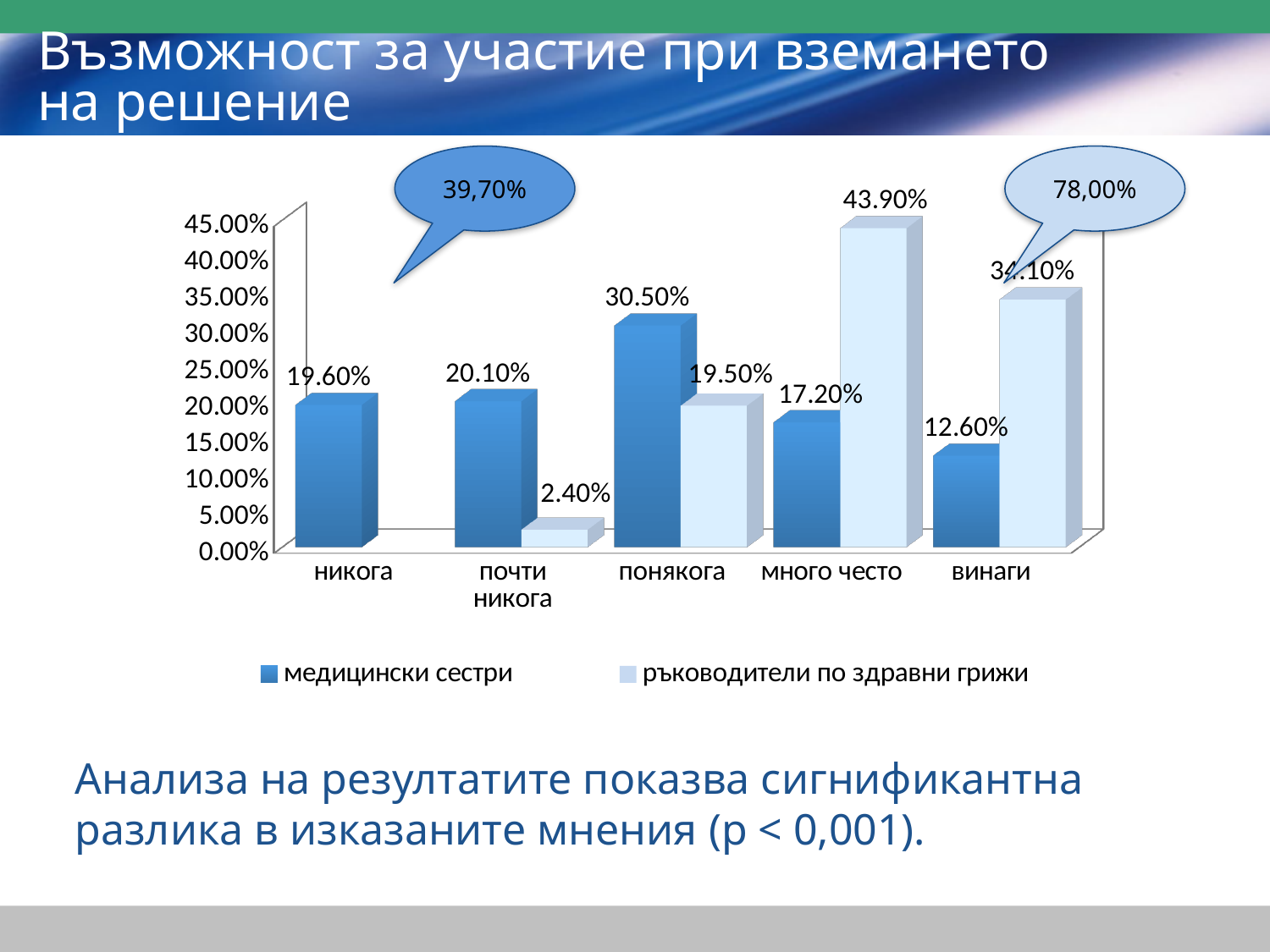
Is the value for ръководители по здравни грижи in the винаги category greater or less than 30.00%? greater What is the value for медицински сестри in the понякога category? 30.50% In the понякога category, which series has the larger value: медицински сестри or ръководители по здравни грижи? медицински сестри In which category is the value for медицински сестри the highest? понякога What is the value for ръководители по здравни грижи in the много често category? 43.90% What is the value for ръководители по здравни грижи in the почти никога category? 2.40% How many series does the legend list? 2 In the много често category, what is the difference between the value for ръководители по здравни грижи and the value for медицински сестри? 26.70% What kind of chart is shown on the slide? bar chart In which category is the value for медицински сестри the lowest? винаги How many categories are shown on the x axis? 5 What value is shown in the callout bubble at the top right of the chart? 78,00%